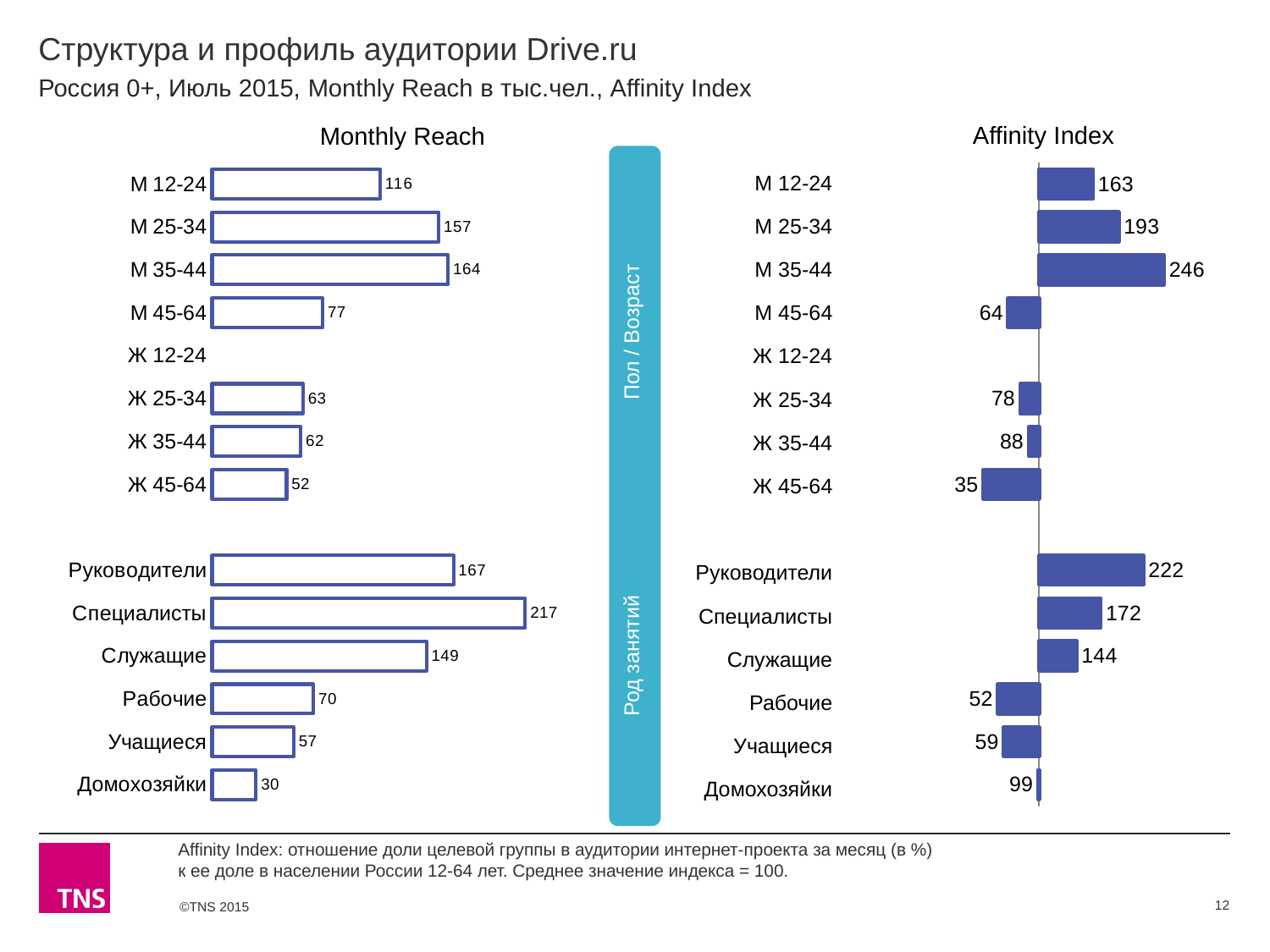
In the Affinity Index chart, which category has the lowest value? Ж 45-64 In the Affinity Index chart, what is the value for Домохозяйки? 99 In the Affinity Index chart, what is the value for Руководители? 222 In the Monthly Reach chart, what is the value for M 35-44? 164 In the Monthly Reach chart, what is the difference between M 25-34 and Ж 25-34? 94 In the Affinity Index chart, what is the difference between M 35-44 and M 45-64? 182 In the Monthly Reach chart, how many categories are in the Род занятий group? 6 In the Affinity Index chart, which category has the highest value? M 35-44 In the Monthly Reach chart, what is the value for Домохозяйки? 30 What kind of chart is the Monthly Reach chart? Bar chart In the Monthly Reach chart, which category has the highest value? Специалисты In the Affinity Index chart, which is larger: M 12-24 or Специалисты? Специалисты